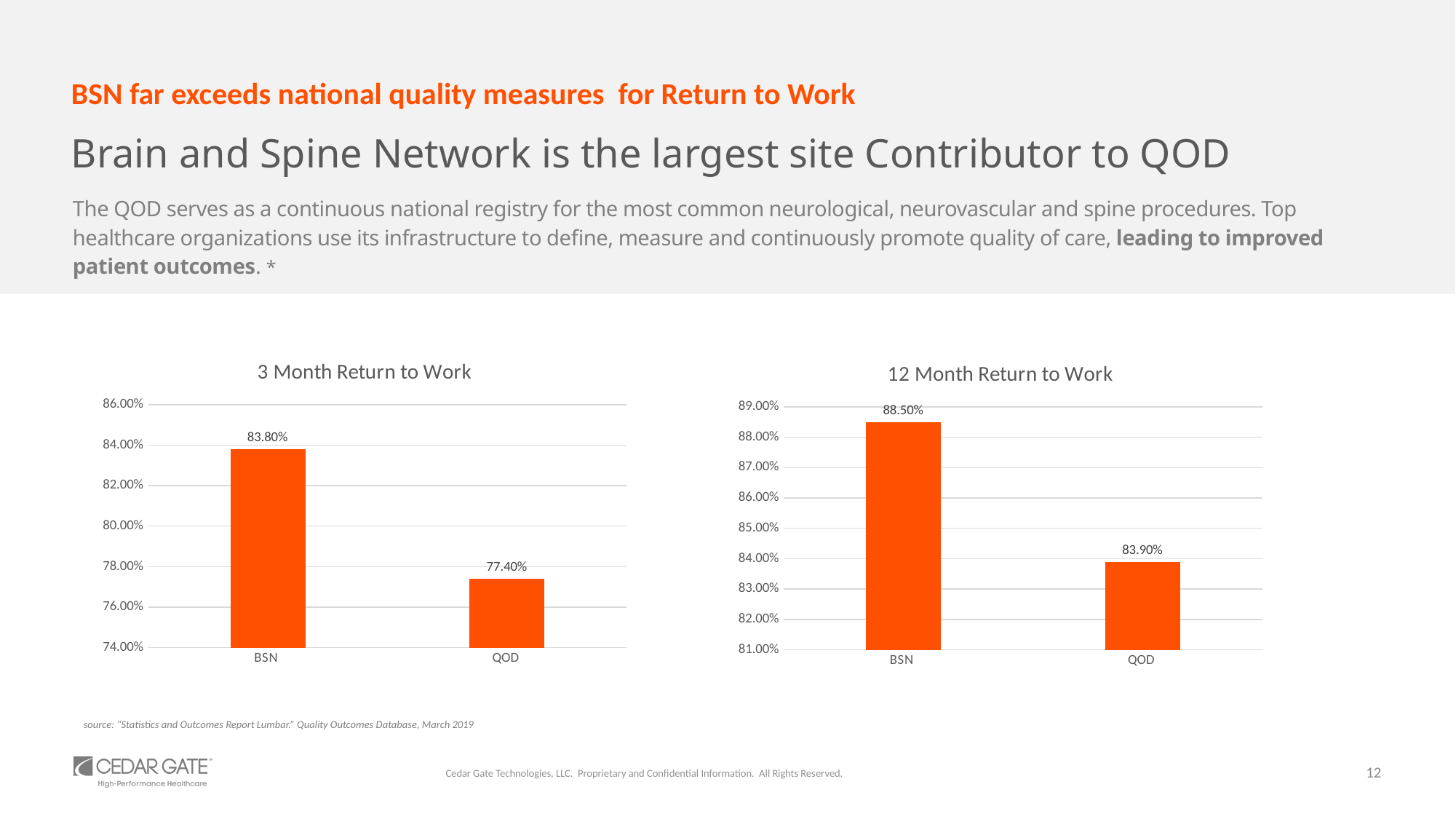
In the '3 Month Return to Work' chart, what is the value for BSN? 83.80% In the '12 Month Return to Work' chart, which category has the lowest value? QOD In the '12 Month Return to Work' chart, what is the value for BSN? 88.50% What kind of chart is the '3 Month Return to Work' chart? bar chart In the '3 Month Return to Work' chart, what is the value for QOD? 77.40% In the '3 Month Return to Work' chart, what is the difference between the BSN and QOD values? 6.40% In the '3 Month Return to Work' chart, which category has the highest value? BSN In the '12 Month Return to Work' chart, which is larger, the value for BSN or the value for QOD? BSN In the '3 Month Return to Work' chart, is the value for QOD greater or less than 78.00%? less In the '12 Month Return to Work' chart, what is the difference between the BSN and QOD values? 4.60% In the '12 Month Return to Work' chart, what is the value for QOD? 83.90% How many categories are shown in the '12 Month Return to Work' chart? 2